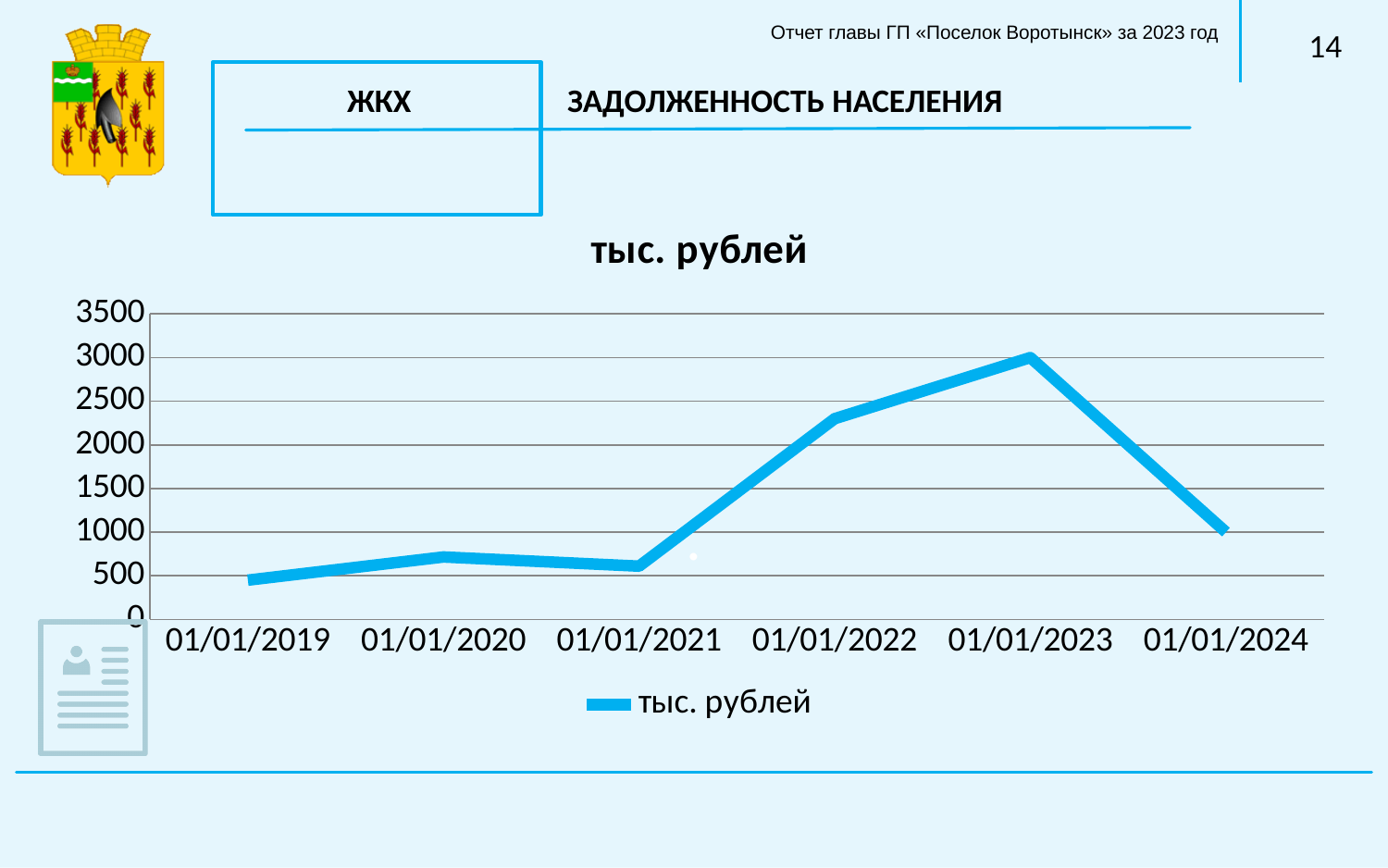
On which date does the line reach its highest value? 01/01/2023 What is the title of the chart? тыс. рублей How many series does the legend list? 1 Is the value for 01/01/2023 greater or less than 2500? greater How many data points are plotted on the line chart? 6 Does the line rise or fall between 01/01/2021 and 01/01/2023? rise On which date does the line have its lowest value? 01/01/2019 Is the value for 01/01/2024 greater or less than 1500? less Is the value for 01/01/2021 greater or less than 1000? less What kind of chart is shown on the slide? line chart Which is larger, the value for 01/01/2023 or the value for 01/01/2024? 01/01/2023